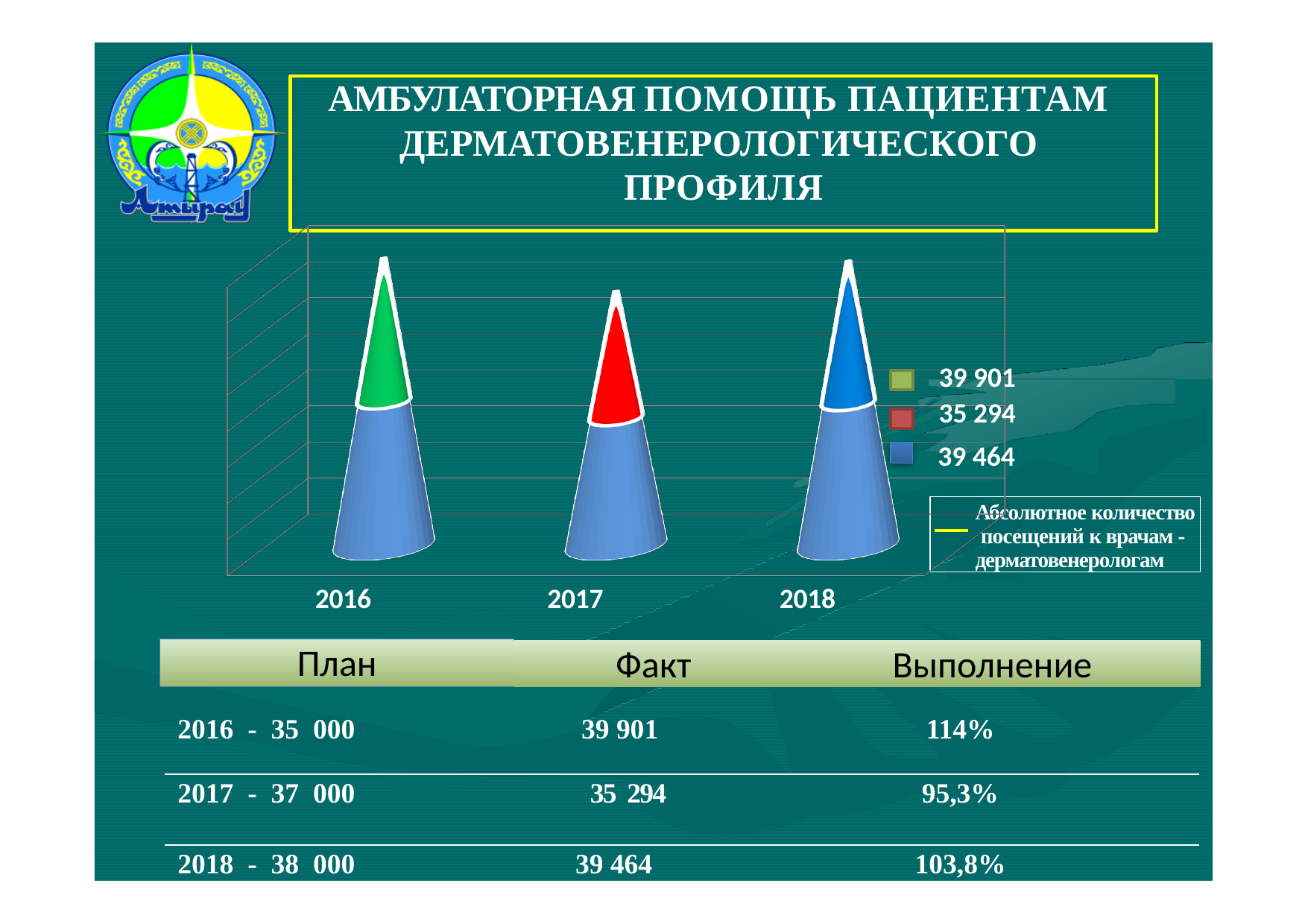
Which year has the highest value in the chart? 2016 What is the value shown for 2017 in the chart? 35 294 What colour is the cone for 2017? red Which year has the lowest value in the chart? 2017 What is the value shown for 2018 in the chart? 39 464 What is the value shown for 2016 in the chart? 39 901 How many entries does the chart legend list? 3 Which is larger, the value for 2017 or the value for 2018? 2018 What is the difference between the values for 2016 and 2017? 4 607 What is the difference between the values for 2018 and 2017? 4 170 Does the value fall or rise from 2016 to 2017? fall How many years are shown on the x axis of the chart? 3